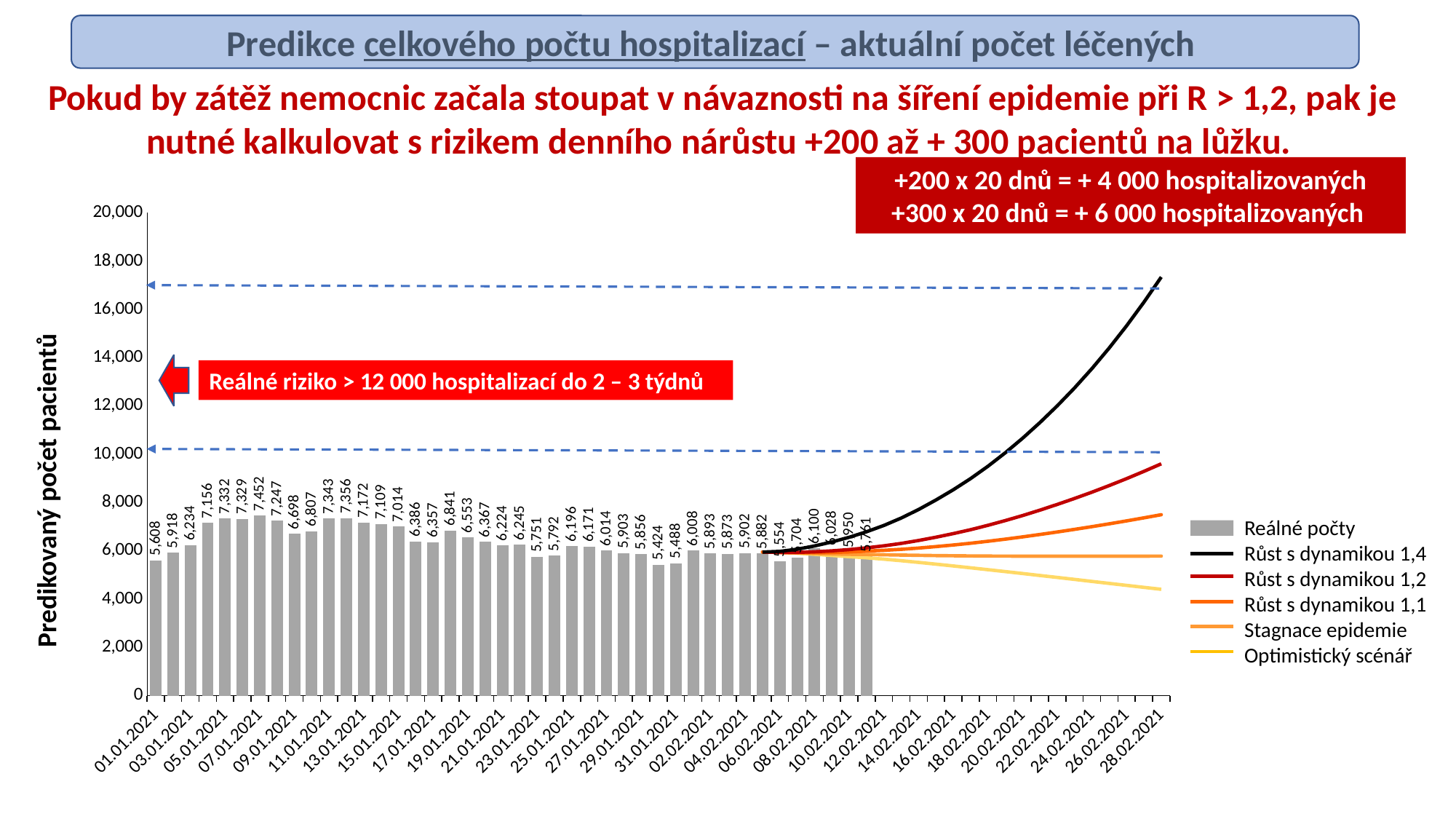
Is the value of the 'Růst s dynamikou 1,4' line at 28.02.2021 greater or less than 16,000? greater Does the 'Růst s dynamikou 1,4' line rise or fall from 12.02.2021 to 28.02.2021? Rises Which bar is larger: 01.01.2021 or 03.01.2021? 03.01.2021 What is the highest value among the labelled bars (Reálné počty)? 7,452 What is the lowest value among the labelled bars (Reálné počty)? 5,424 What kind of chart is shown on the slide? Combined bar and line chart Is the value of the 'Optimistický scénář' line at 28.02.2021 greater or less than 6,000? less What is the value of the bar for 01.01.2021? 5,608 What is the value of the bar for 07.01.2021? 7,452 What is the difference between the highest bar value (7,452) and the bar for 01.01.2021 (5,608)? 1,844 How many series does the legend list? 6 What is the title of the vertical axis? Predikovaný počet pacientů